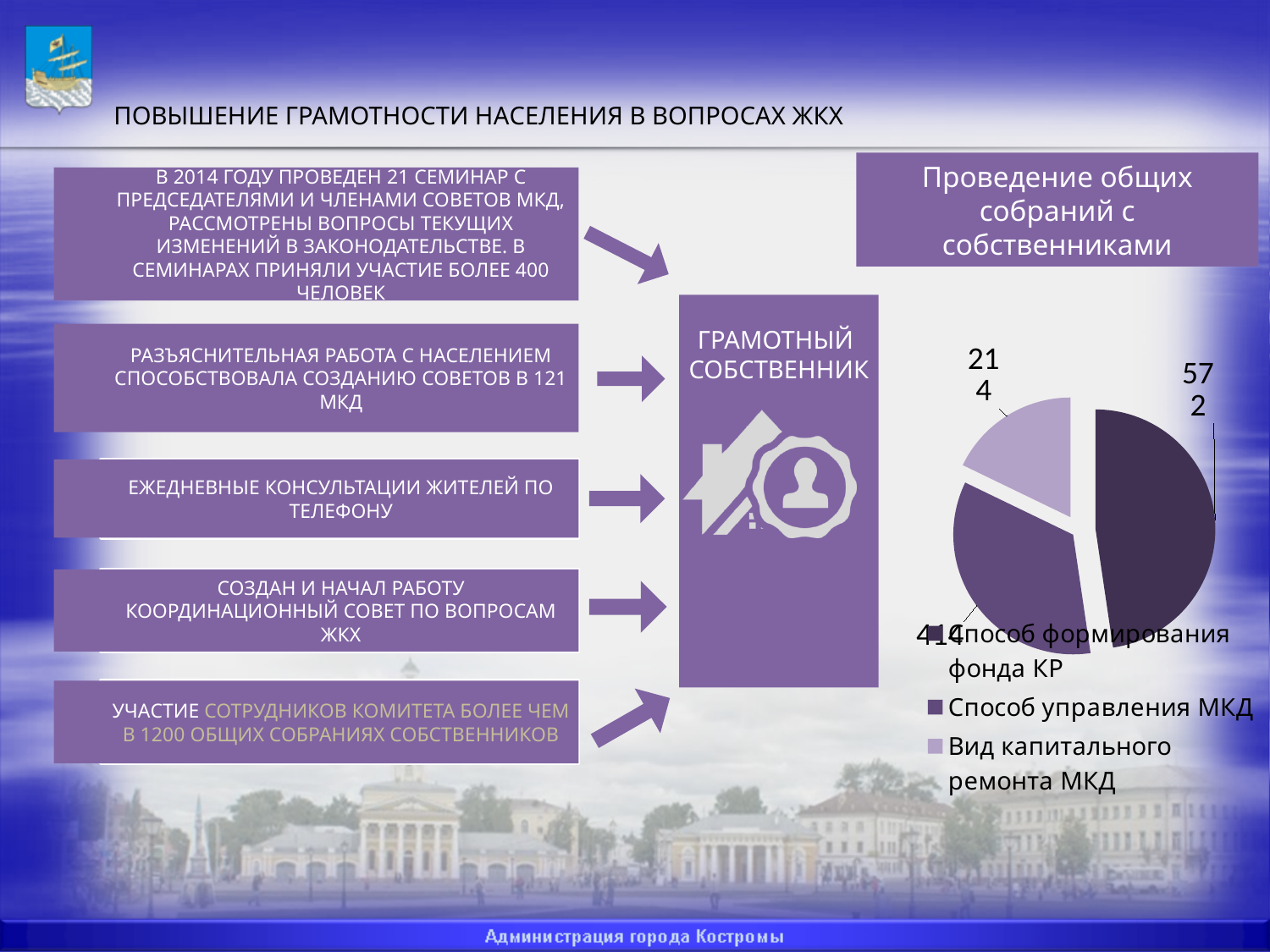
What is the value for "Способ управления МКД" in the pie chart? 414 Which category has the largest slice in the pie chart? Способ формирования фонда КР How many entries does the chart legend list? 3 What is the title of the chart on the slide? Проведение общих собраний с собственниками Which is larger in the pie chart: "Способ управления МКД" or "Вид капитального ремонта МКД"? Способ управления МКД What type of chart is shown on the slide? pie chart How many slices does the pie chart have? 3 What is the difference between the values for "Способ формирования фонда КР" and "Вид капитального ремонта МКД"? 358 Which category has the smallest slice in the pie chart? Вид капитального ремонта МКД What is the value for "Вид капитального ремонта МКД" in the pie chart? 214 Which colour represents "Вид капитального ремонта МКД" in the pie chart? light purple What is the value for "Способ формирования фонда КР" in the pie chart? 572